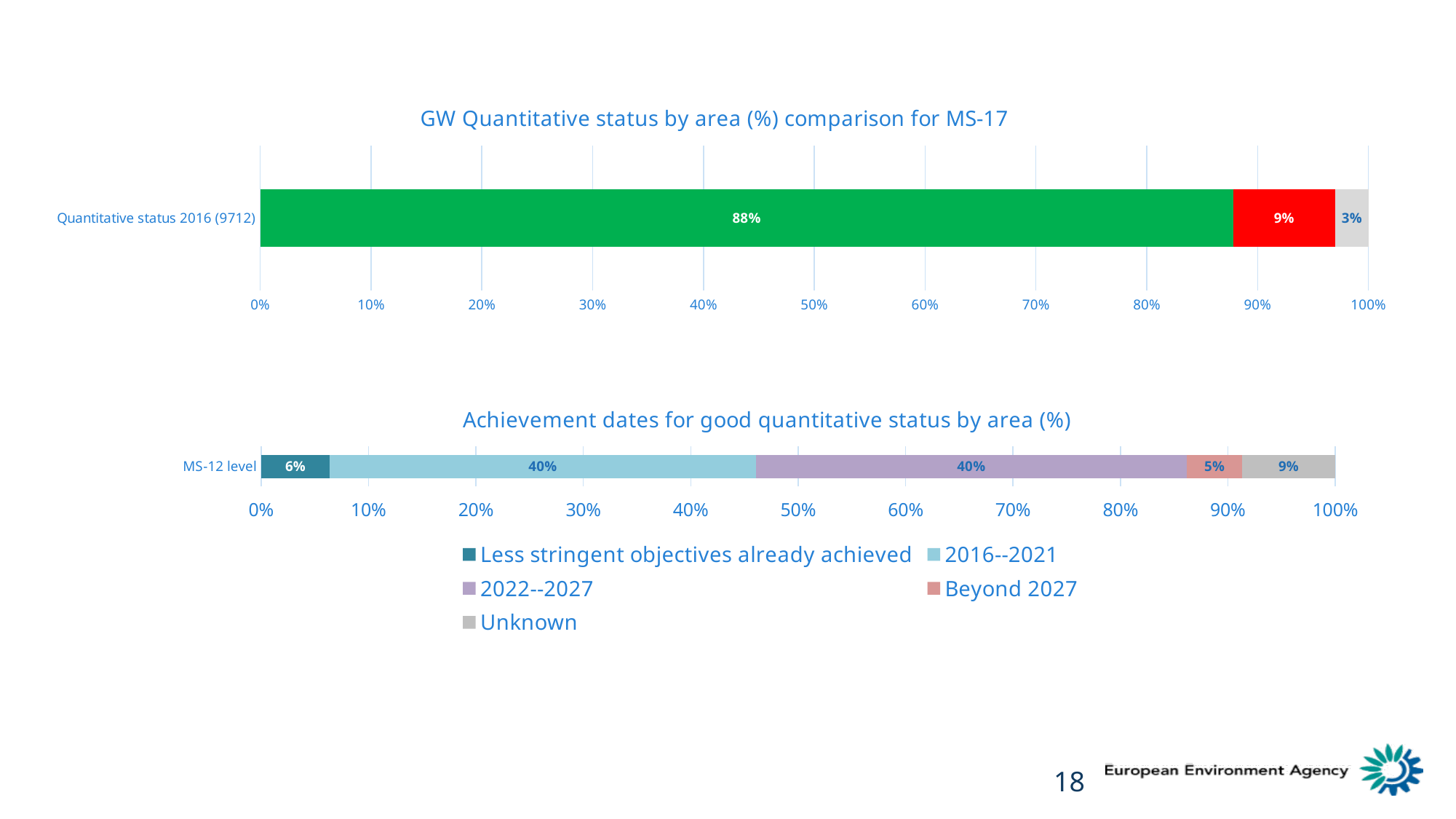
In the chart titled "Achievement dates for good quantitative status by area (%)", what is the value for Beyond 2027? 5% In the top chart titled "GW Quantitative status by area (%) comparison for MS-17", what is the difference between the green segment and the red segment? 79% In the top chart titled "GW Quantitative status by area (%) comparison for MS-17", what is the value of the green segment? 88% In the chart titled "Achievement dates for good quantitative status by area (%)", which series has the smallest share of the MS-12 level bar? Beyond 2027 In the top chart titled "GW Quantitative status by area (%) comparison for MS-17", what is the value of the red segment? 9% In the chart titled "Achievement dates for good quantitative status by area (%)", which is larger: the Unknown value or the Beyond 2027 value? Unknown In the chart titled "Achievement dates for good quantitative status by area (%)", what is the value for 2016--2021 at MS-12 level? 40% In the chart titled "Achievement dates for good quantitative status by area (%)", what is the value for Unknown? 9% In the chart titled "Achievement dates for good quantitative status by area (%)", what is the value for "Less stringent objectives already achieved"? 6% In the chart titled "Achievement dates for good quantitative status by area (%)", how many series does the legend list? 5 What kind of chart is the top chart titled "GW Quantitative status by area (%) comparison for MS-17"? Stacked bar chart In the chart titled "Achievement dates for good quantitative status by area (%)", what is the difference between the 2022--2027 value and the "Less stringent objectives already achieved" value? 34%